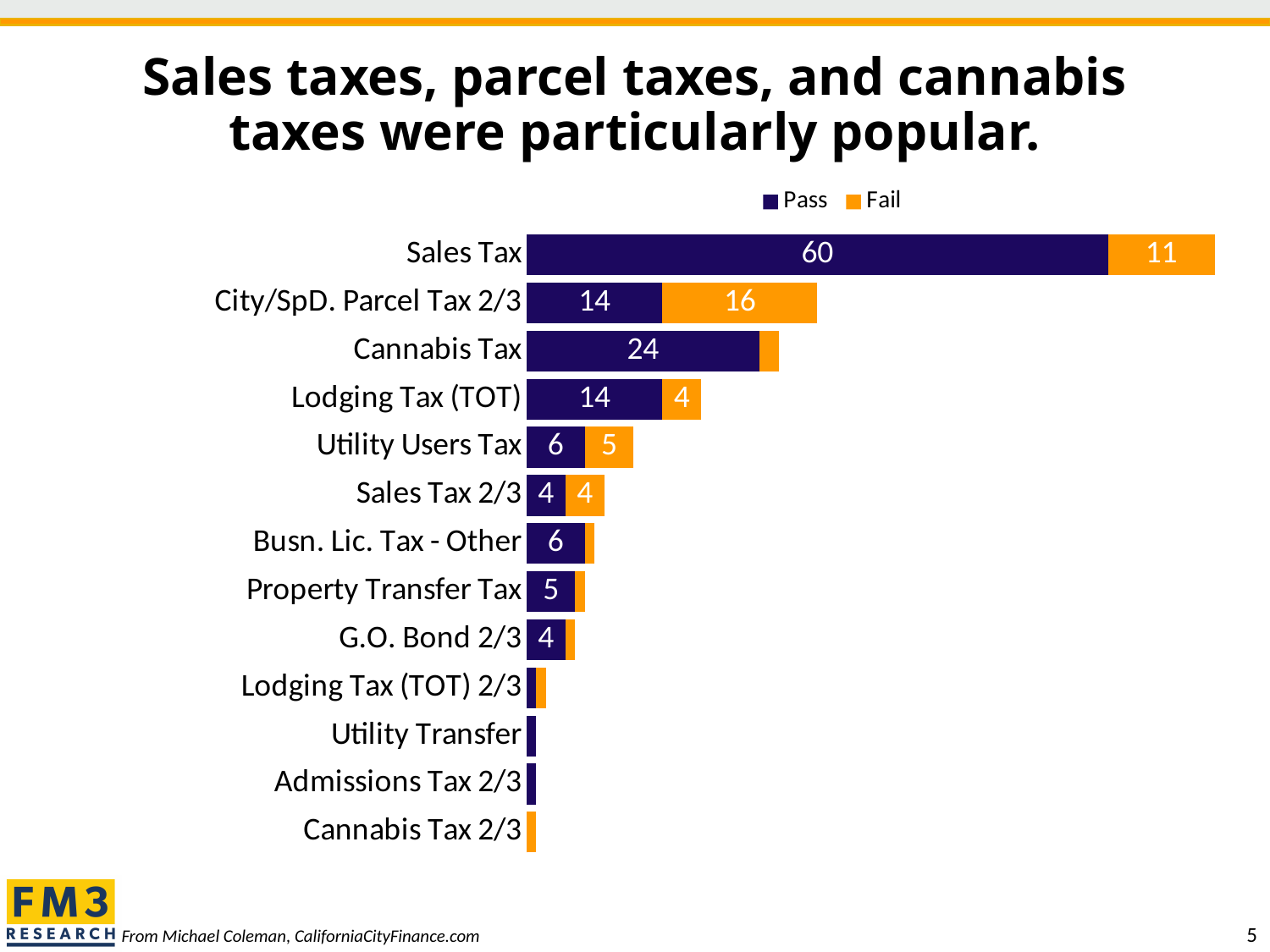
What is the total of the stacked bar for Utility Users Tax? 11 How many categories are shown on the chart? 13 What is the Pass value for Sales Tax? 60 How many series does the legend list? 2 What is the Pass value for Cannabis Tax? 24 Which is larger for City/SpD. Parcel Tax 2/3, the Pass value or the Fail value? Fail Which category has the highest Pass value? Sales Tax What is the Fail value for City/SpD. Parcel Tax 2/3? 16 What kind of chart is shown on the slide? Stacked bar chart What is the total of the stacked bar for City/SpD. Parcel Tax 2/3? 30 What is the difference between the Pass and Fail values for Sales Tax? 49 What is the Fail value for Lodging Tax (TOT)? 4